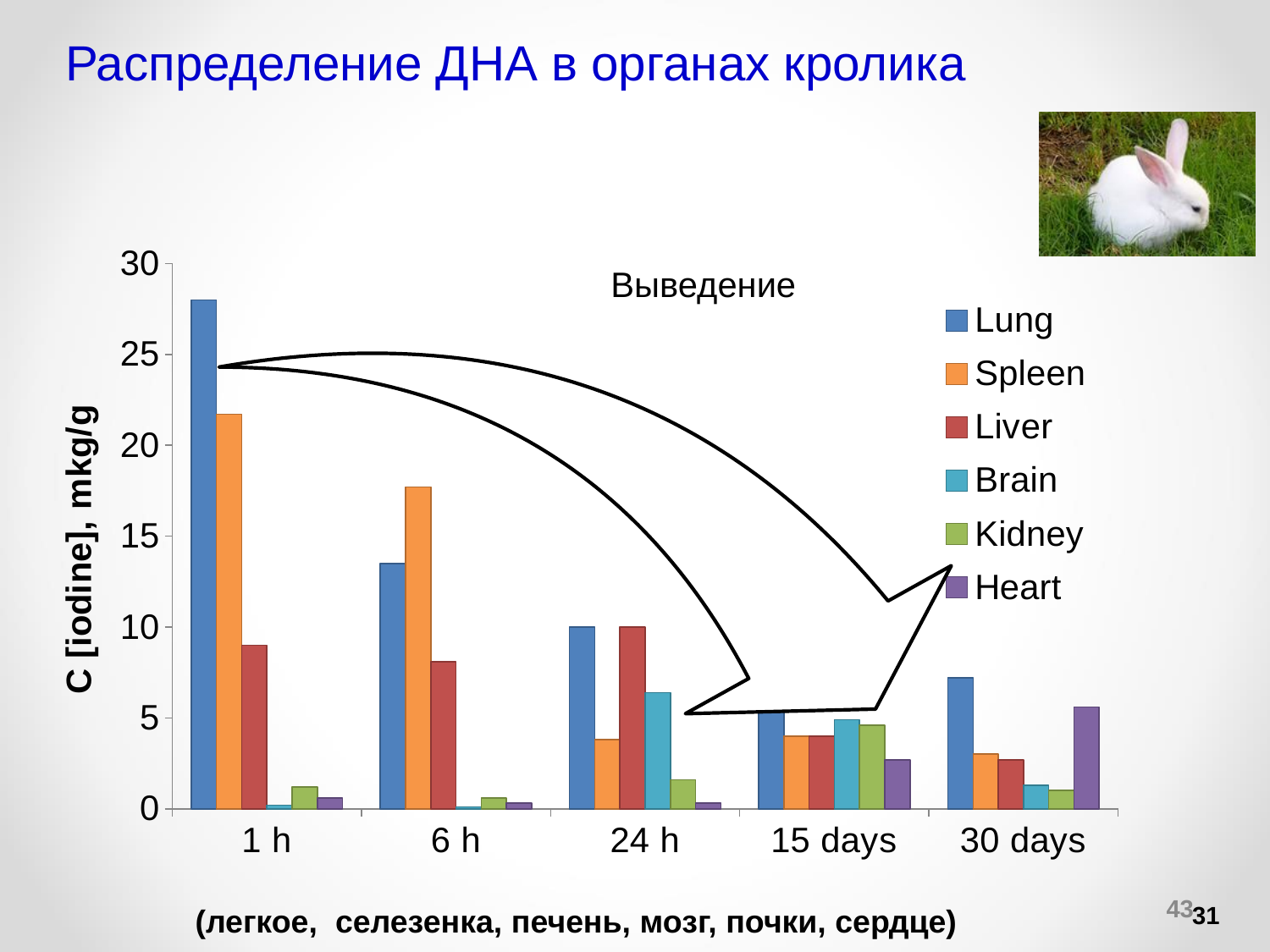
Which organ has the lowest value at 1 h? Brain At 1 h, which is larger, the Lung value or the Spleen value? Lung Is the Liver value at 1 h greater or less than 10? less How many time points are shown on the x axis? 5 Does the Lung value rise or fall from 1 h to 15 days? fall Is the Spleen value at 6 h greater or less than 15? greater What kind of chart is shown on the slide? bar chart At which time point is the Lung value highest? 1 h What is the label on the y axis? C [iodine], mkg/g At 30 days, which is larger, the Heart value or the Spleen value? Heart How many series does the legend list? 6 Is the Lung value at 1 h greater or less than 25? greater